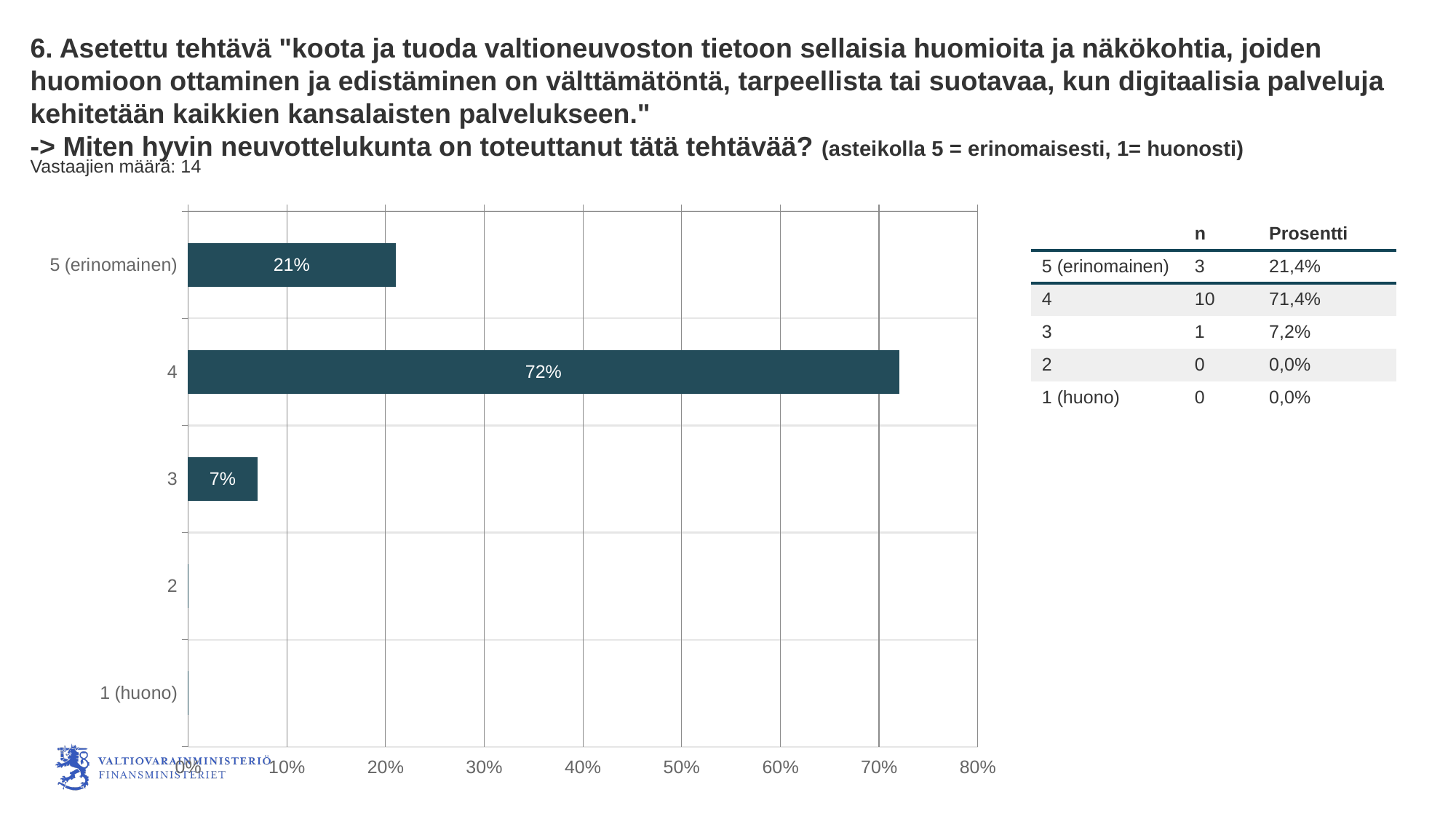
How many categories are shown on the vertical axis of the bar chart? 5 What kind of chart is shown on the slide? bar chart What is the difference between the values for category "4" and category "5 (erinomainen)" in the bar chart? 51% What is the value shown for the category "4" in the bar chart? 72% Which category has the highest value in the bar chart? 4 Is the value for category "4" greater or less than 50%? greater What is the number of respondents (Vastaajien määrä) stated on the slide? 14 According to the table, how many respondents (n) chose "4"? 10 According to the table, what is the percentage (Prosentti) for "3"? 7,2% Which is larger in the bar chart: the value for "5 (erinomainen)" or the value for "3"? 5 (erinomainen) What is the value shown for the category "5 (erinomainen)" in the bar chart? 21% What is the value shown for the category "3" in the bar chart? 7%